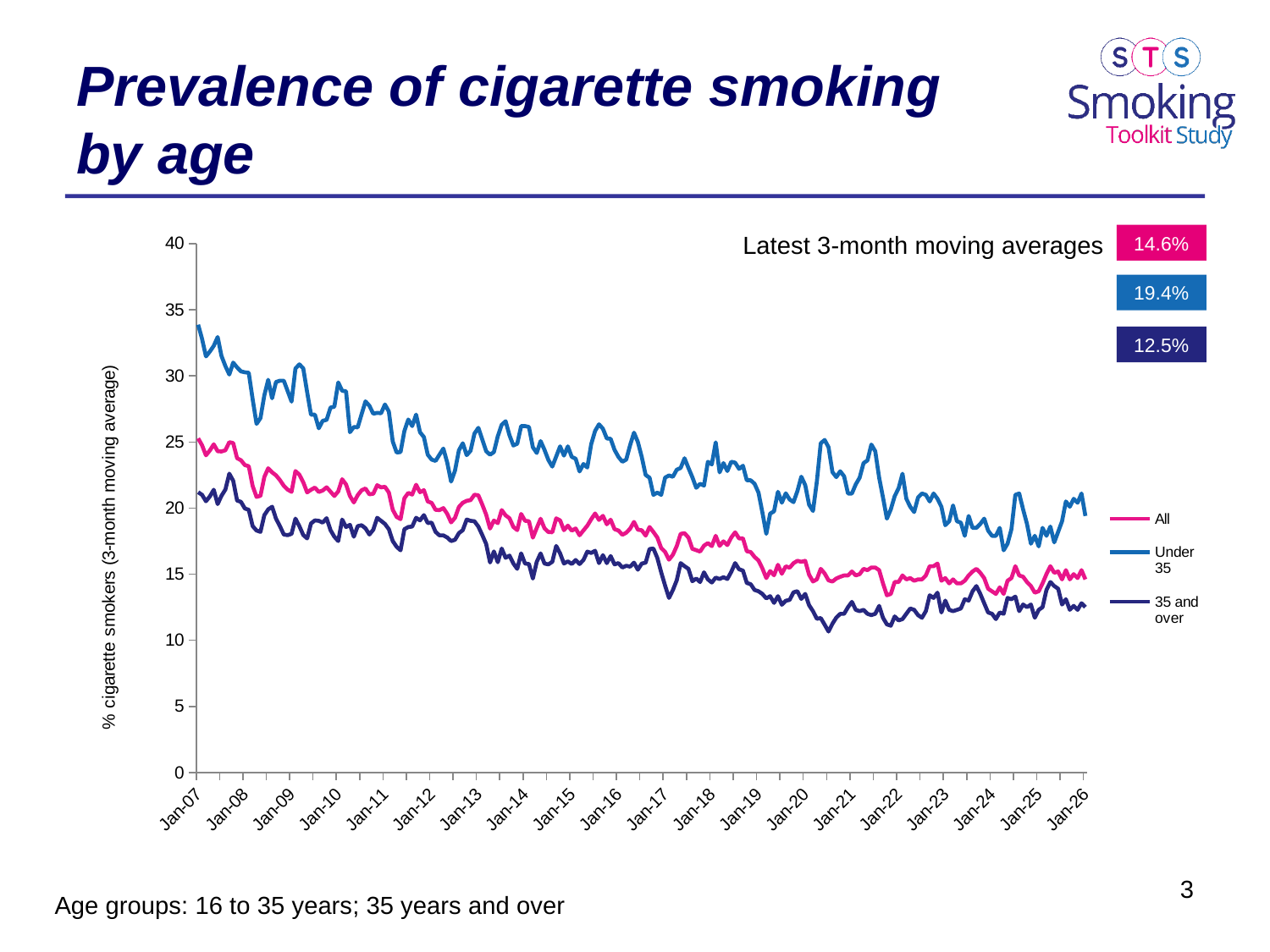
What is the latest 3-month moving average for the Under 35 group? 19.4% Is the value for 35 and over at Jan-26 greater or less than 15? less What is the difference between the latest 3-month moving averages for Under 35 and 35 and over? 6.9% What is the label of the y axis? % cigarette smokers (3-month moving average) Which age group has the highest latest 3-month moving average? Under 35 Does the Under 35 line generally rise or fall from Jan-07 to Jan-26? fall What is the latest 3-month moving average for the 35 and over group? 12.5% How many series does the legend list? 3 Which age group has the lowest latest 3-month moving average? 35 and over Is the value for Under 35 at Jan-07 greater or less than 30? greater What is the latest 3-month moving average for All? 14.6% What kind of chart is shown on the slide? line chart